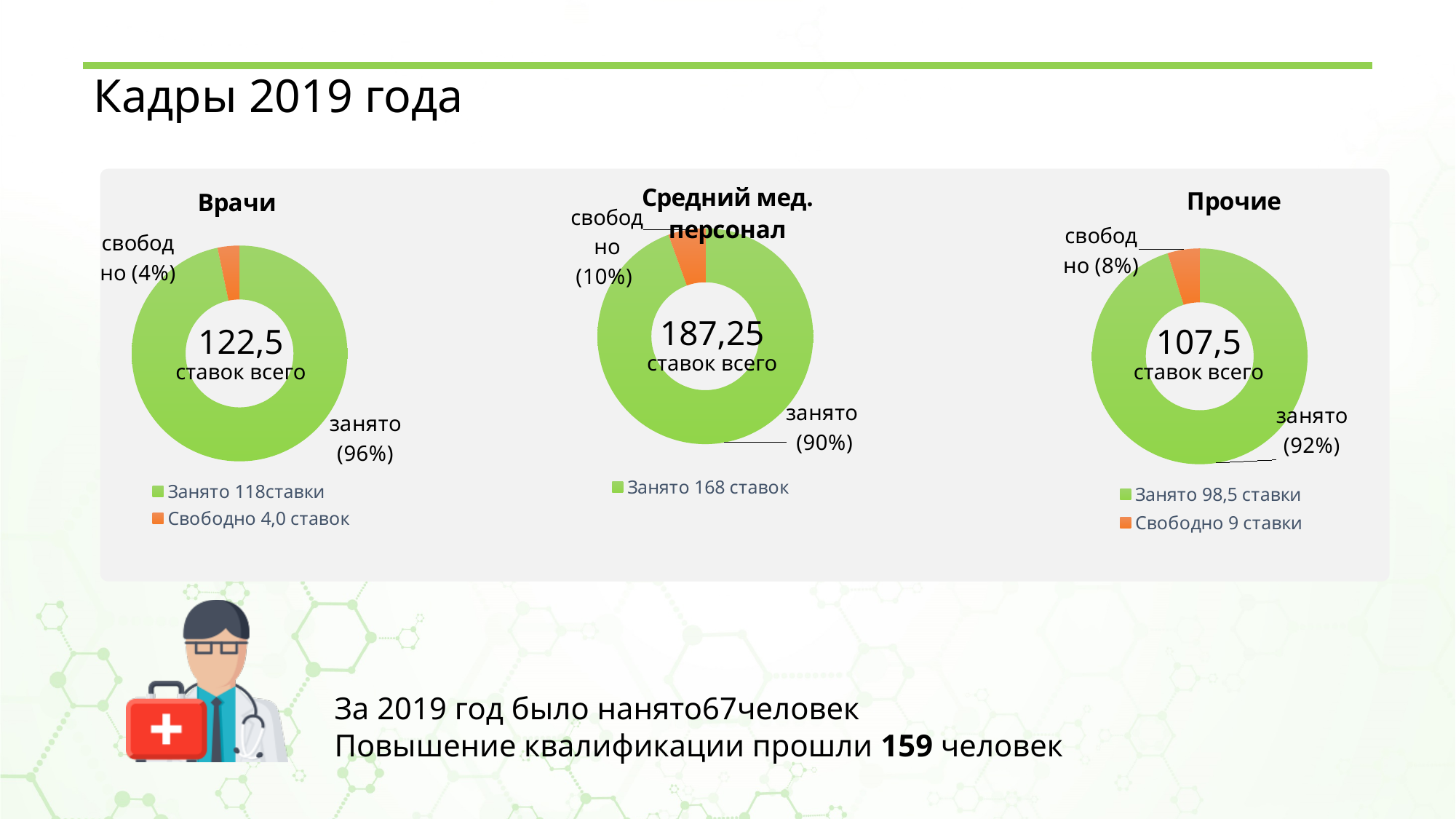
In the "Прочие" chart, by how many percentage points does the "занято" share exceed the "свободно" share? 84 In the "Врачи" chart, what share of positions is labelled "занято"? 96% What kind of chart is used for the "Врачи" data? Donut (pie) chart How many donut charts are shown on the slide? 3 What colour represents "занято" in the charts? Green How many entries does the legend of the "Врачи" chart list? 2 In the "Средний мед. персонал" chart, what share is labelled "свободно"? 10% In the "Прочие" chart, how many positions are listed as "Занято" in the legend? 98,5 ставки Across the three charts, which staff category has the highest "свободно" share? Средний мед. персонал Which chart shows a larger "свободно" share, "Врачи" or "Прочие"? Прочие In the "Врачи" chart, how many positions are listed as "Свободно" in the legend? 4,0 ставок What total number of positions ("ставок всего") is shown in the centre of the "Средний мед. персонал" chart? 187,25